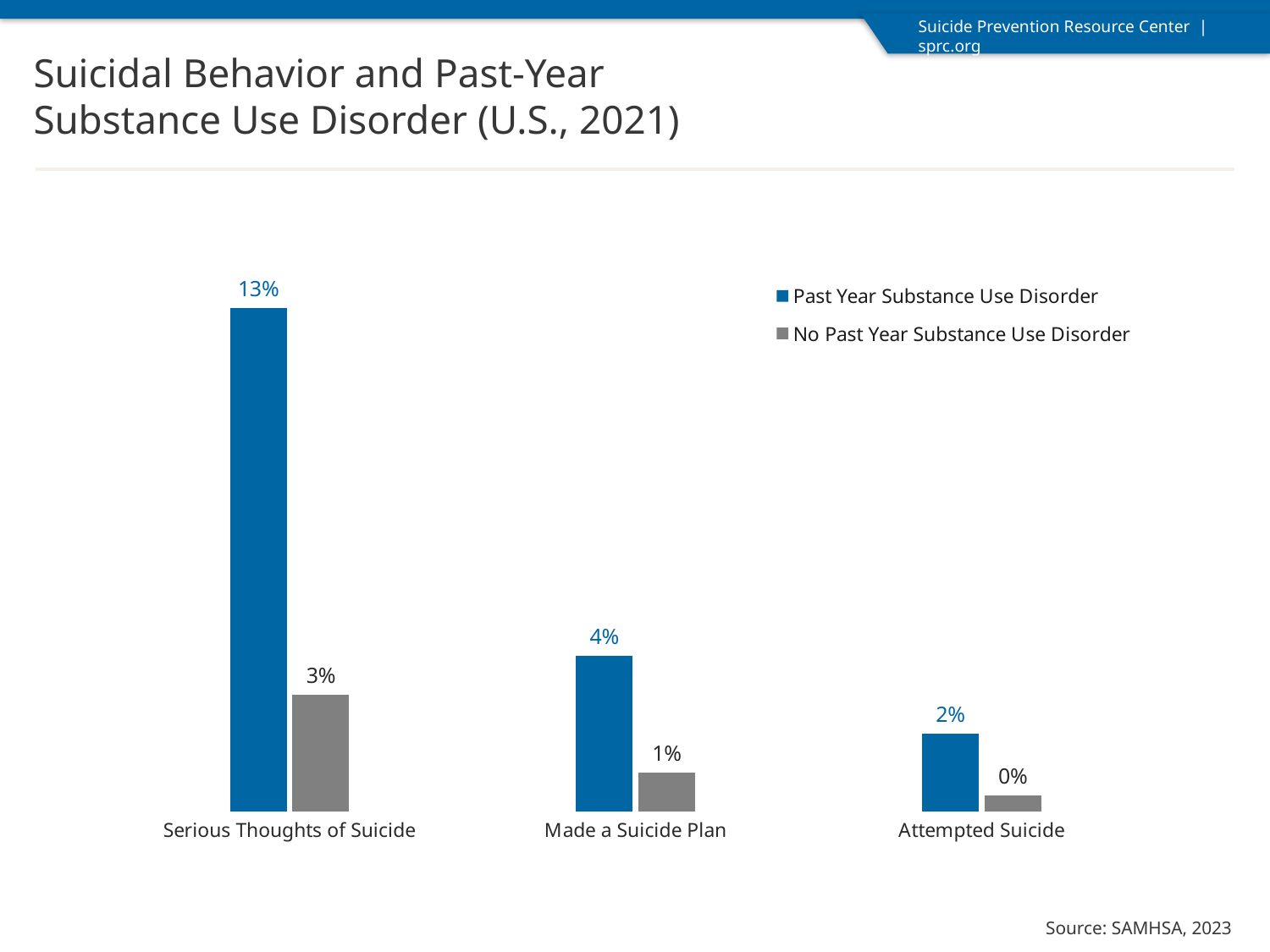
What is the difference between the Past Year Substance Use Disorder and No Past Year Substance Use Disorder values for Serious Thoughts of Suicide? 10% What kind of chart is shown on the slide? Bar chart How many series does the legend list? 2 What is the value for Past Year Substance Use Disorder in the Attempted Suicide category? 2% What is the value for No Past Year Substance Use Disorder in the Made a Suicide Plan category? 1% Which is larger for Made a Suicide Plan: Past Year Substance Use Disorder or No Past Year Substance Use Disorder? Past Year Substance Use Disorder Which category has the highest value for Past Year Substance Use Disorder? Serious Thoughts of Suicide Which category has the lowest value for No Past Year Substance Use Disorder? Attempted Suicide How many categories are shown on the x axis? 3 What is the value for No Past Year Substance Use Disorder in the Attempted Suicide category? 0% What is the difference between the Past Year Substance Use Disorder and No Past Year Substance Use Disorder values for Made a Suicide Plan? 3% What is the value for Past Year Substance Use Disorder in the Serious Thoughts of Suicide category? 13%